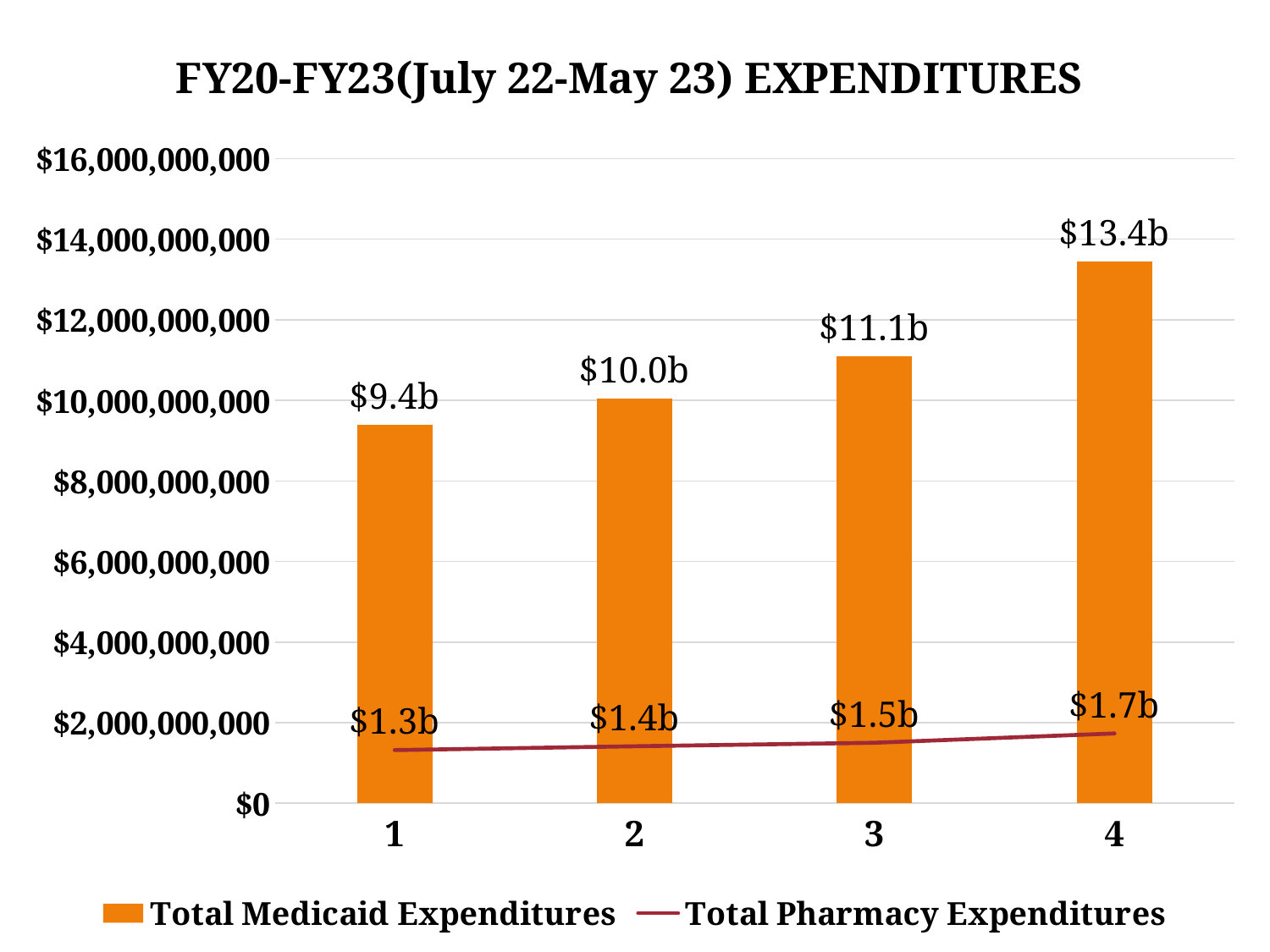
Is the Total Medicaid Expenditures value for category 4 greater or less than $12,000,000,000? greater What is the difference between Total Medicaid Expenditures for category 4 and category 1? $4.1b How many categories are shown on the x axis? 4 Do the Total Pharmacy Expenditures values rise or fall from category 1 to category 4? rise Which category has the lowest Total Pharmacy Expenditures? 1 What is the Total Medicaid Expenditures value for category 1? $9.4b Which is larger: Total Medicaid Expenditures for category 2 or category 3? category 3 Which category has the highest Total Medicaid Expenditures? 4 What is the title of the chart? FY20-FY23(July 22-May 23) EXPENDITURES What is the Total Pharmacy Expenditures value for category 4? $1.7b What is the Total Medicaid Expenditures value for category 3? $11.1b How many series does the legend list? 2